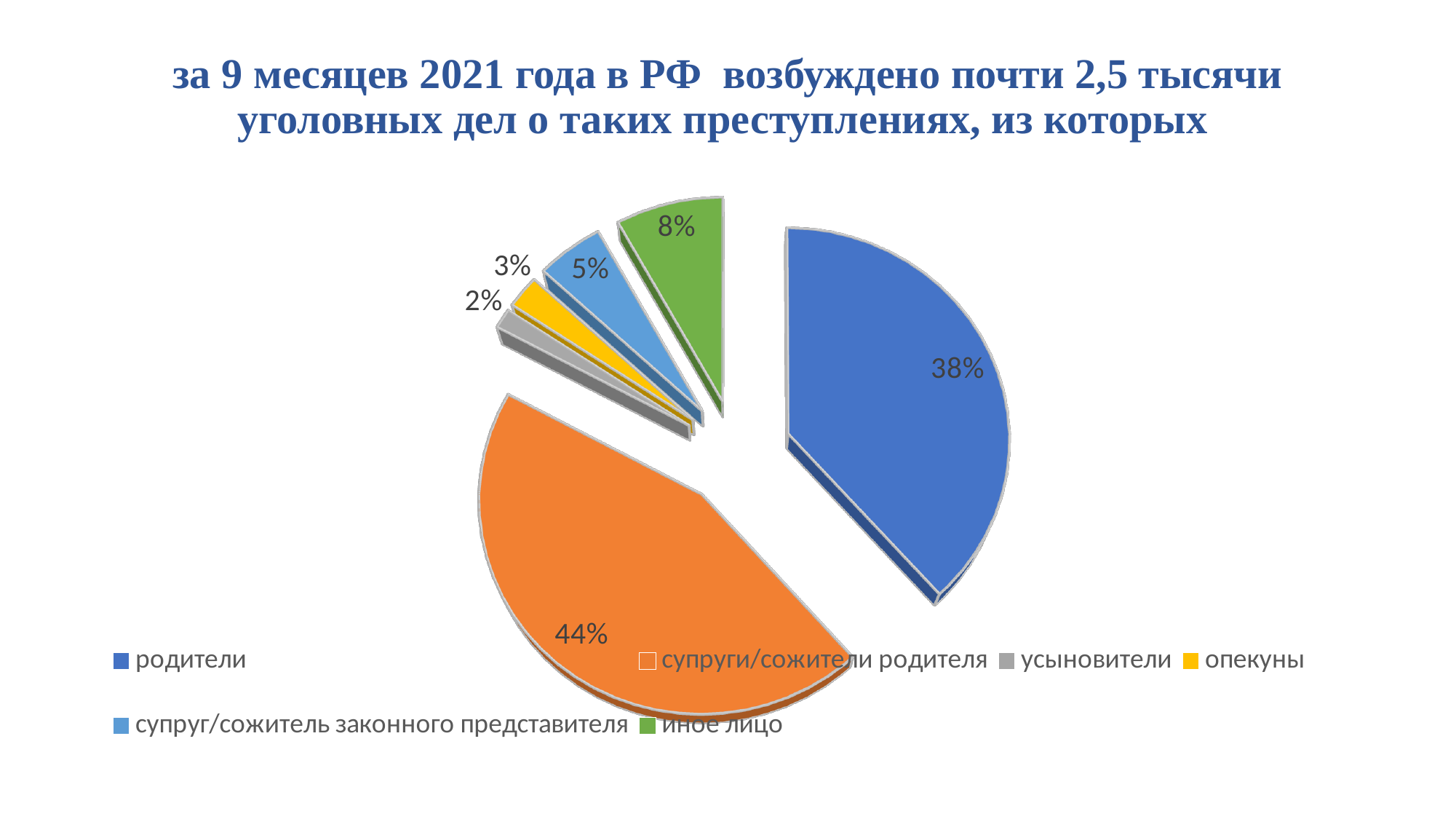
What share of the pie is labelled for "супруг/сожитель законного представителя"? 5% Which category has the smallest slice of the pie? усыновители How many categories does the legend of the pie chart list? 6 Which is larger, the slice for "иное лицо" or the slice for "супруг/сожитель законного представителя"? иное лицо What share of the pie is labelled for "опекуны"? 3% What share of the pie is labelled for "супруги/сожители родителя"? 44% What share of the pie is labelled for "родители"? 38% What share of the pie is labelled for "иное лицо"? 8% What share of the pie is labelled for "усыновители"? 2% What is the difference in percentage points between the slices for "супруги/сожители родителя" and "родители"? 6 Which category has the largest slice of the pie? супруги/сожители родителя What kind of chart is shown on the slide? pie chart